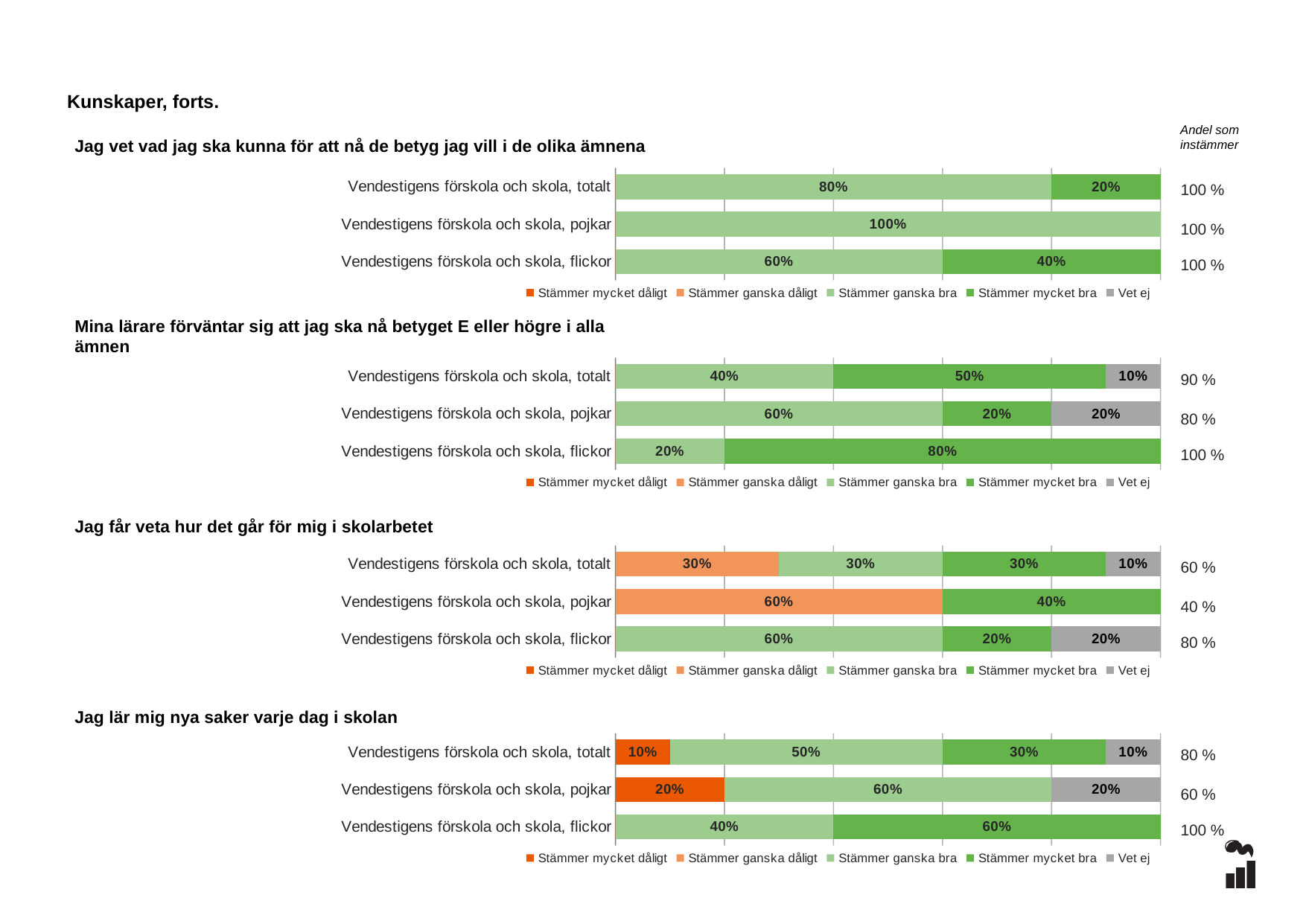
How many series does the legend list for the chart 'Jag får veta hur det går för mig i skolarbetet'? 5 What kind of chart is 'Jag vet vad jag ska kunna för att nå de betyg jag vill i de olika ämnena'? Stacked bar chart In the chart 'Jag lär mig nya saker varje dag i skolan', what is the 'Stämmer mycket dåligt' value for 'Vendestigens förskola och skola, pojkar'? 20% In the chart 'Jag lär mig nya saker varje dag i skolan', which is larger: the 'Stämmer ganska bra' value for 'pojkar' or for 'flickor'? pojkar In the chart 'Mina lärare förväntar sig att jag ska nå betyget E eller högre i alla ämnen', what is the 'Vet ej' value for 'Vendestigens förskola och skola, pojkar'? 20% How many categories are shown in the chart 'Mina lärare förväntar sig att jag ska nå betyget E eller högre i alla ämnen'? 3 In the chart 'Mina lärare förväntar sig att jag ska nå betyget E eller högre i alla ämnen', what is the 'Andel som instämmer' value for 'Vendestigens förskola och skola, totalt'? 90 % In the chart 'Jag lär mig nya saker varje dag i skolan', what is the difference between the 'Stämmer mycket bra' value for 'flickor' and for 'totalt'? 30% In the chart 'Jag vet vad jag ska kunna för att nå de betyg jag vill i de olika ämnena', what is the 'Stämmer mycket bra' value for 'Vendestigens förskola och skola, flickor'? 40% In the chart 'Jag får veta hur det går för mig i skolarbetet', which category has the lowest 'Andel som instämmer'? Vendestigens förskola och skola, pojkar In the chart 'Jag vet vad jag ska kunna för att nå de betyg jag vill i de olika ämnena', what is the 'Stämmer ganska bra' value for 'Vendestigens förskola och skola, totalt'? 80% In the chart 'Jag får veta hur det går för mig i skolarbetet', what is the 'Stämmer ganska dåligt' value for 'Vendestigens förskola och skola, pojkar'? 60%